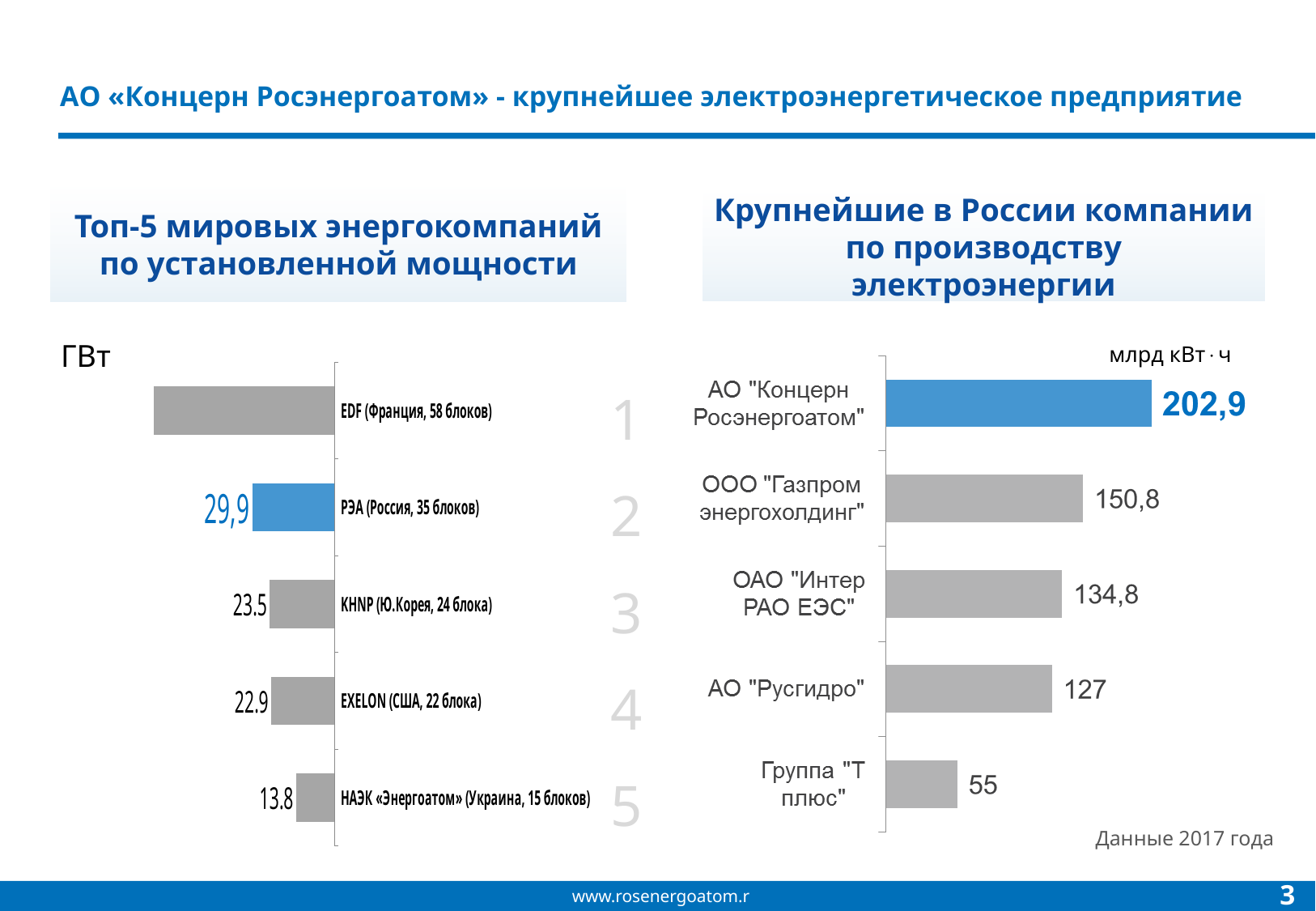
On the chart 'Топ-5 мировых энергокомпаний по установленной мощности', which company has the lowest value? НАЭК «Энергоатом» (Украина, 15 блоков) On the chart 'Крупнейшие в России компании по производству электроэнергии', what is the value for ООО "Газпром энергохолдинг"? 150,8 On the chart 'Топ-5 мировых энергокомпаний по установленной мощности', which company has the highest value? EDF (Франция, 58 блоков) On the chart 'Топ-5 мировых энергокомпаний по установленной мощности', what is the value for EXELON (США, 22 блока)? 22.9 On the chart 'Топ-5 мировых энергокомпаний по установленной мощности', what is the value for РЭА (Россия, 35 блоков)? 29,9 On the chart 'Крупнейшие в России компании по производству электроэнергии', what is the value for АО "Концерн Росэнергоатом"? 202,9 On the chart 'Крупнейшие в России компании по производству электроэнергии', what is the value for Группа "Т плюс"? 55 On the chart 'Крупнейшие в России компании по производству электроэнергии', what is the difference between АО "Концерн Росэнергоатом" and ООО "Газпром энергохолдинг"? 52,1 What kind of chart is 'Топ-5 мировых энергокомпаний по установленной мощности'? Bar chart On the chart 'Крупнейшие в России компании по производству электроэнергии', which company has the lowest value? Группа "Т плюс" How many companies are shown on the chart 'Крупнейшие в России компании по производству электроэнергии'? 5 On the chart 'Крупнейшие в России компании по производству электроэнергии', which is larger: ОАО "Интер РАО ЕЭС" or АО "Русгидро"? ОАО "Интер РАО ЕЭС"